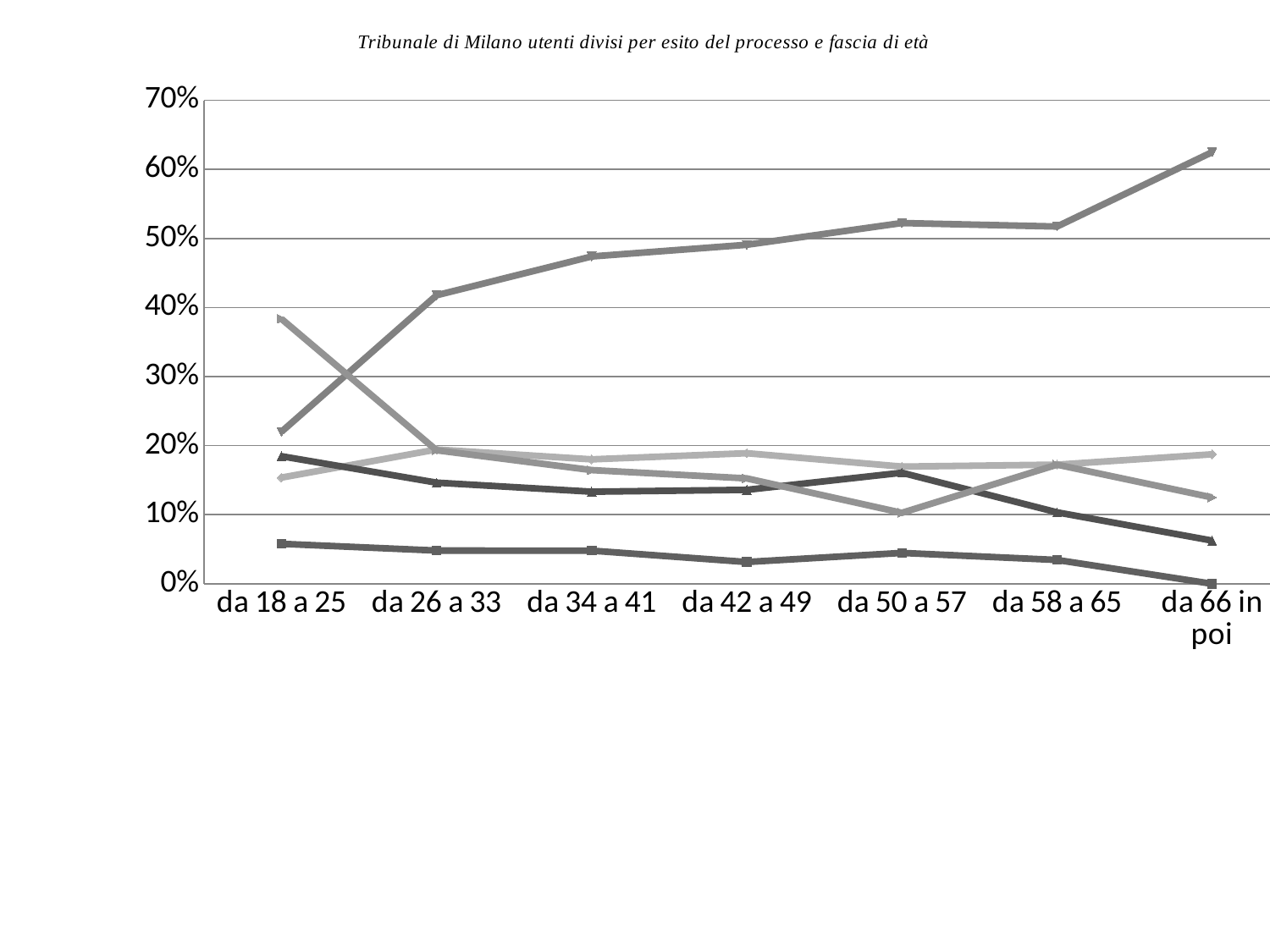
Is the highest plotted value at 'da 18 a 25' larger or smaller than the highest plotted value at 'da 66 in poi'? smaller Is the highest plotted value at 'da 18 a 25' greater or less than 30%? greater How many age-group categories are shown on the x axis? 7 Is the lowest plotted value at 'da 66 in poi' greater or less than 10%? less What kind of chart is shown on the slide? line chart What is the highest tick value shown on the y axis? 70% Is the lowest plotted value at 'da 18 a 25' greater or less than 10%? less Does the line that reaches the highest value at 'da 66 in poi' rise or fall overall from 'da 18 a 25' to 'da 66 in poi'? rise At which age-group category does the chart reach its single highest plotted value? da 66 in poi What is the title of the chart? Tribunale di Milano utenti divisi per esito del processo e fascia di età